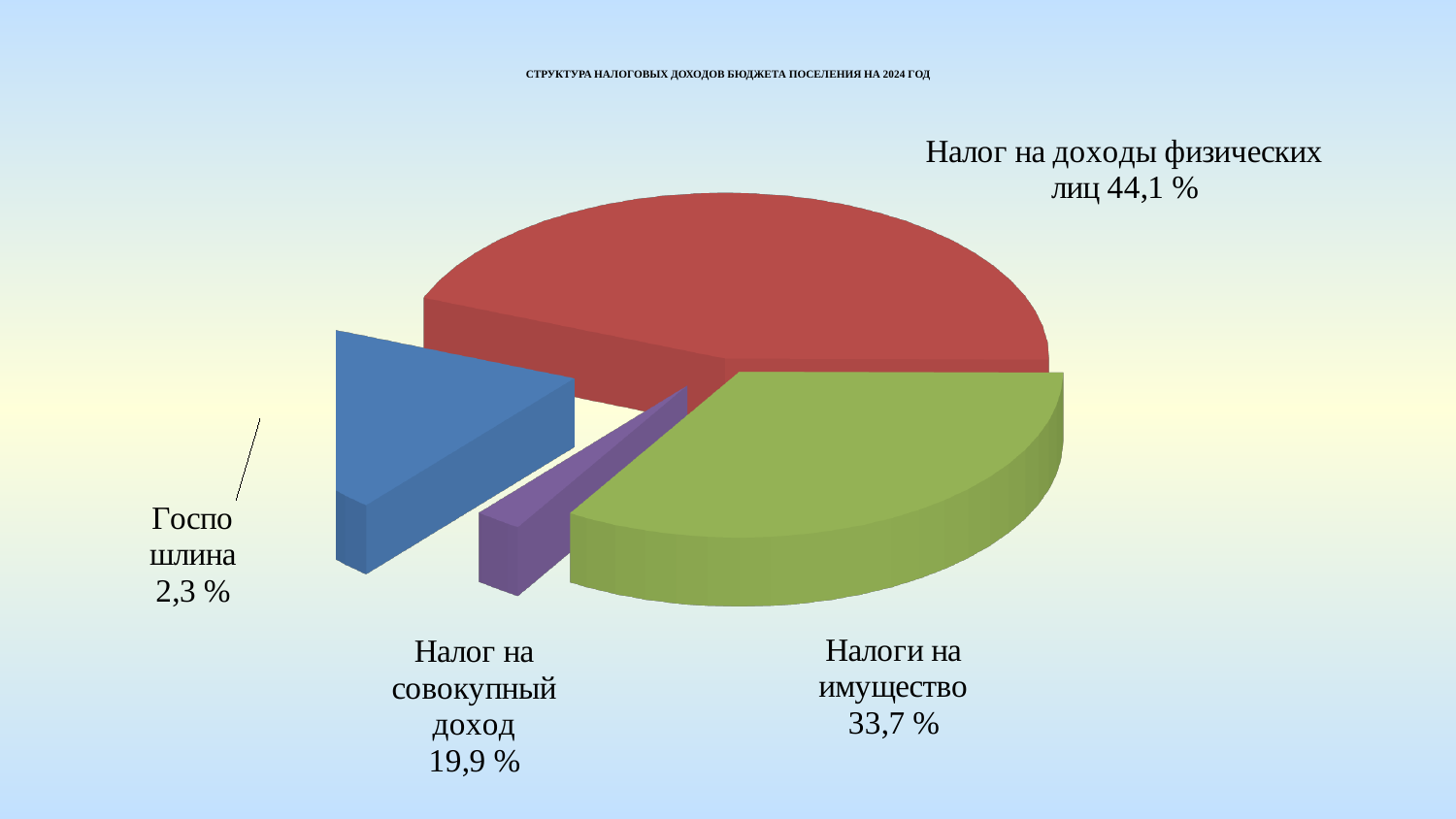
How many slices does the pie chart have? 4 What is the share for Налог на доходы физических лиц? 44,1 % Which category has the largest share of the pie? Налог на доходы физических лиц What is the difference in percentage points between Налог на доходы физических лиц and Налоги на имущество? 10,4 What colour is the slice for Налоги на имущество? Green Which is larger, the share for Налоги на имущество or the share for Налог на совокупный доход? Налоги на имущество What is the share for Госпошлина? 2,3 % Which category has the smallest share of the pie? Госпошлина What is the share for Налог на совокупный доход? 19,9 % What is the title of the chart? СТРУКТУРА НАЛОГОВЫХ ДОХОДОВ БЮДЖЕТА ПОСЕЛЕНИЯ НА 2024 ГОД What kind of chart is shown on the slide? Pie chart What is the share for Налоги на имущество? 33,7 %